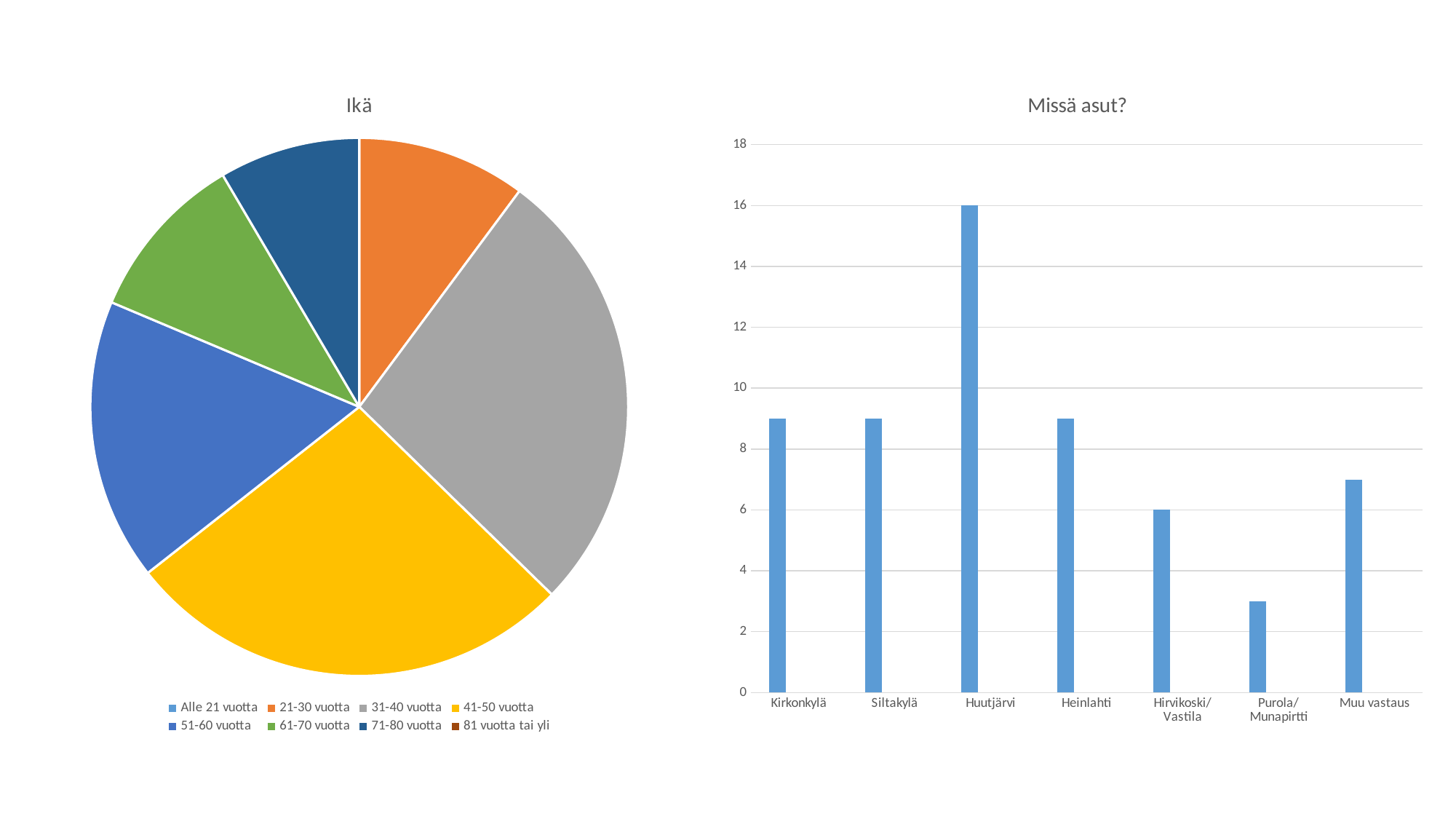
What kind of chart is the chart titled "Ikä"? pie chart On the chart titled "Missä asut?", how many categories are shown on the x axis? 7 On the chart titled "Missä asut?", is the value for Purola/Munapirtti greater or less than 4? less On the chart titled "Missä asut?", what is the value for Hirvikoski/Vastila? 6 On the chart titled "Missä asut?", what is the difference between the values for Huutjärvi and Hirvikoski/Vastila? 10 On the chart titled "Missä asut?", which is larger, the value for Huutjärvi or the value for Muu vastaus? Huutjärvi On the chart titled "Ikä", how many entries does the legend list? 8 On the chart titled "Missä asut?", is the value for Kirkonkylä greater or less than 8? greater On the chart titled "Missä asut?", which category has the highest value? Huutjärvi What kind of chart is the chart titled "Missä asut?"? bar chart On the chart titled "Missä asut?", which category has the lowest value? Purola/Munapirtti On the chart titled "Missä asut?", what is the value for Huutjärvi? 16